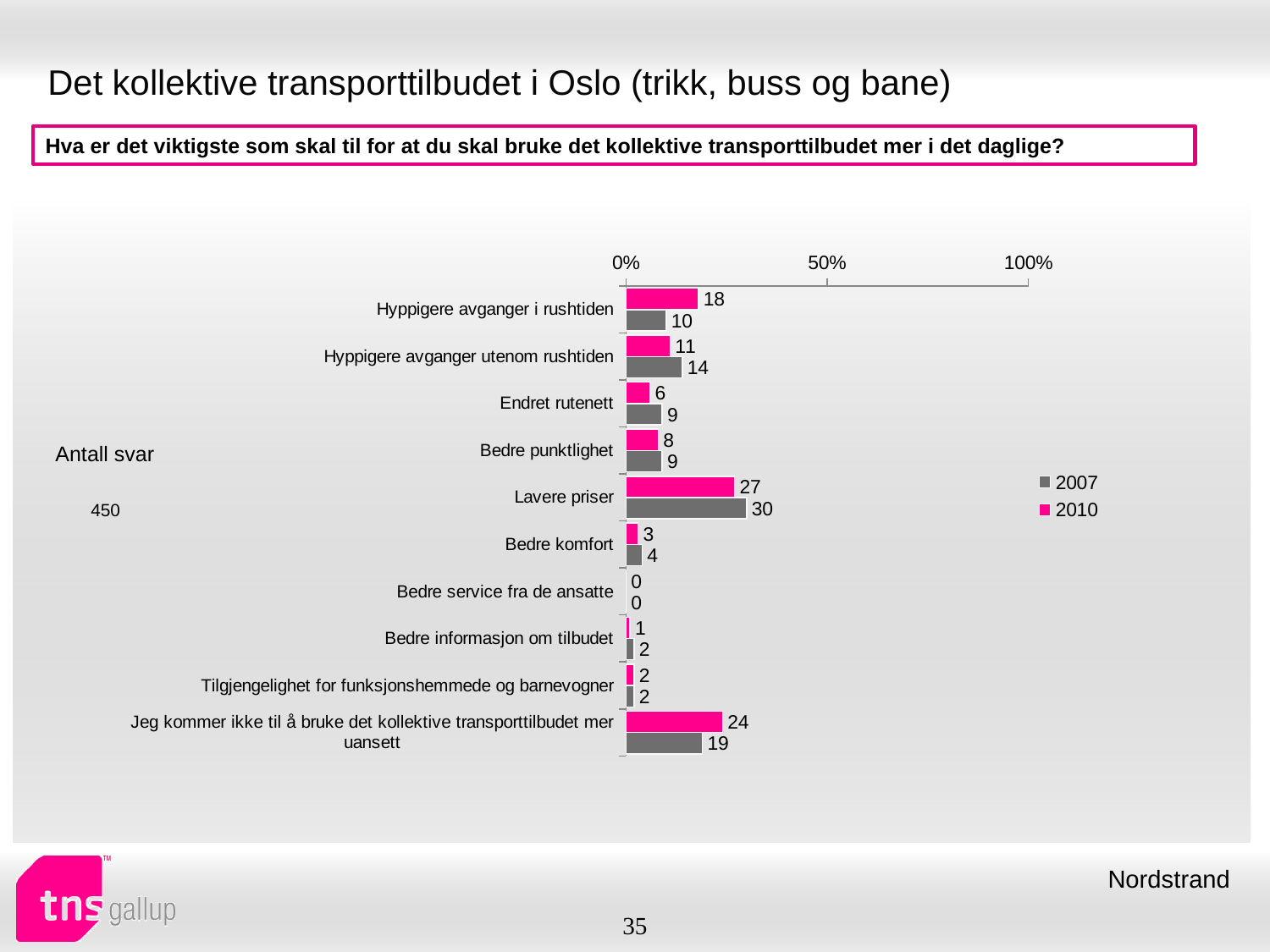
How many series does the legend list? 2 For "Hyppigere avganger utenom rushtiden", which year has the larger value, 2007 or 2010? 2007 How many categories are shown on the chart? 10 Is the 2007 value for "Lavere priser" greater or less than 50%? less Which category has the lowest 2010 value? Bedre service fra de ansatte Which category has the highest 2007 value? Lavere priser What is the 2007 value for "Hyppigere avganger i rushtiden"? 10 What is the 2010 value for "Jeg kommer ikke til å bruke det kollektive transporttilbudet mer uansett"? 24 What is the difference between the 2007 and 2010 values for "Hyppigere avganger i rushtiden"? 8 What kind of chart is shown on the slide? bar chart What is the 2010 value for "Lavere priser"? 27 Which colour represents the 2010 series in the legend? pink